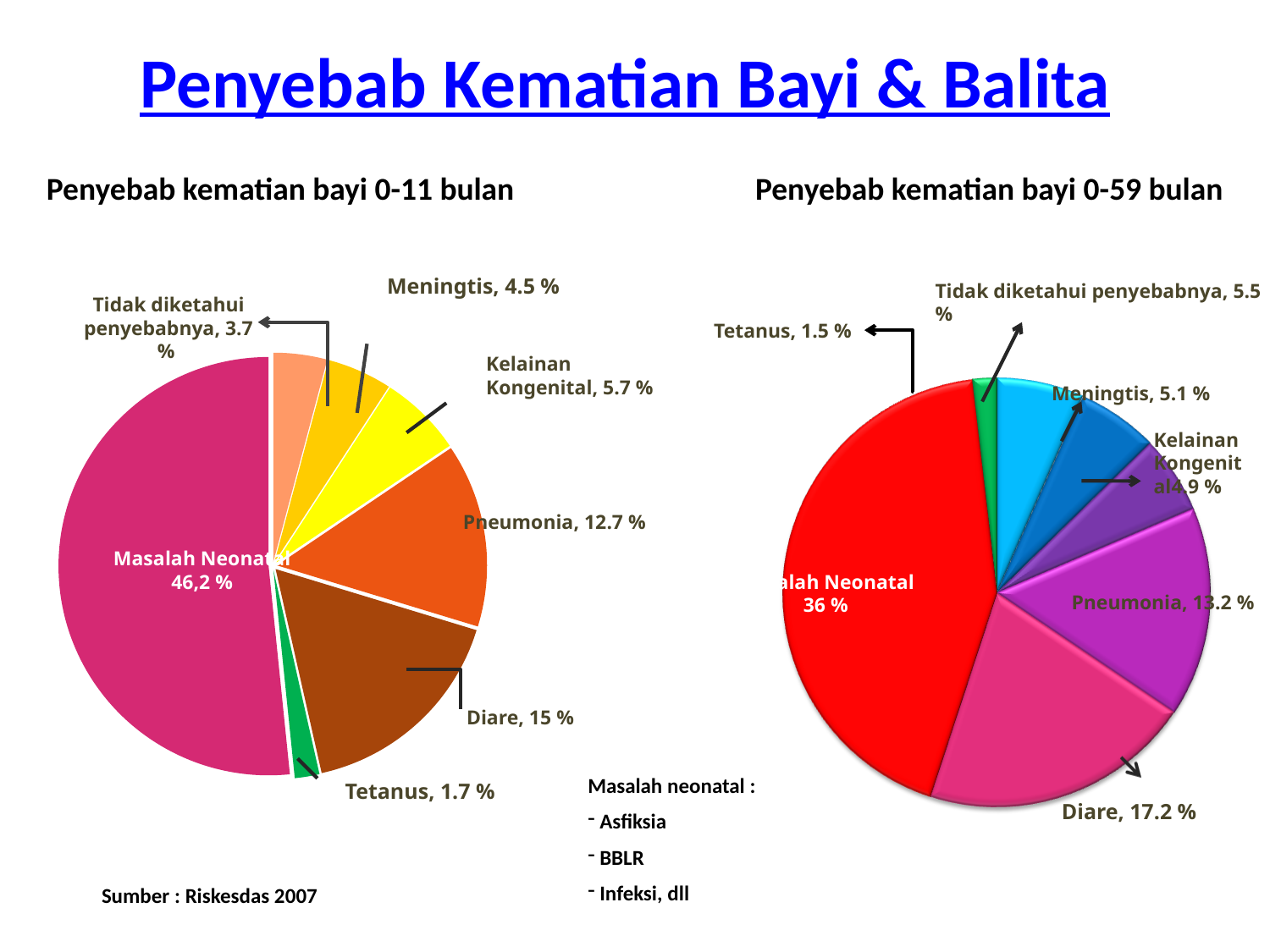
In the 'Penyebab kematian bayi 0-59 bulan' chart, which is larger, Meningtis or Kelainan Kongenital? Meningtis In the 'Penyebab kematian bayi 0-11 bulan' chart, what is the value for Pneumonia? 12.7 % In the 'Penyebab kematian bayi 0-11 bulan' chart, which cause has the smallest share? Tetanus In the 'Penyebab kematian bayi 0-11 bulan' chart, what is the difference between Diare and Pneumonia? 2.3 % In the 'Penyebab kematian bayi 0-11 bulan' chart, how many slices are there? 7 In the 'Penyebab kematian bayi 0-59 bulan' chart, what is the value for Diare? 17.2 % What kind of chart is used for 'Penyebab kematian bayi 0-11 bulan'? Pie chart In the 'Penyebab kematian bayi 0-11 bulan' chart, what is the value for Masalah Neonatal? 46,2 % In the 'Penyebab kematian bayi 0-59 bulan' chart, which cause has the largest share? Masalah Neonatal In the 'Penyebab kematian bayi 0-59 bulan' chart, what is the value for Tetanus? 1.5 % What is the source cited on the slide? Riskesdas 2007 In the 'Penyebab kematian bayi 0-59 bulan' chart, what is the difference between Pneumonia and Tidak diketahui penyebabnya? 7.7 %